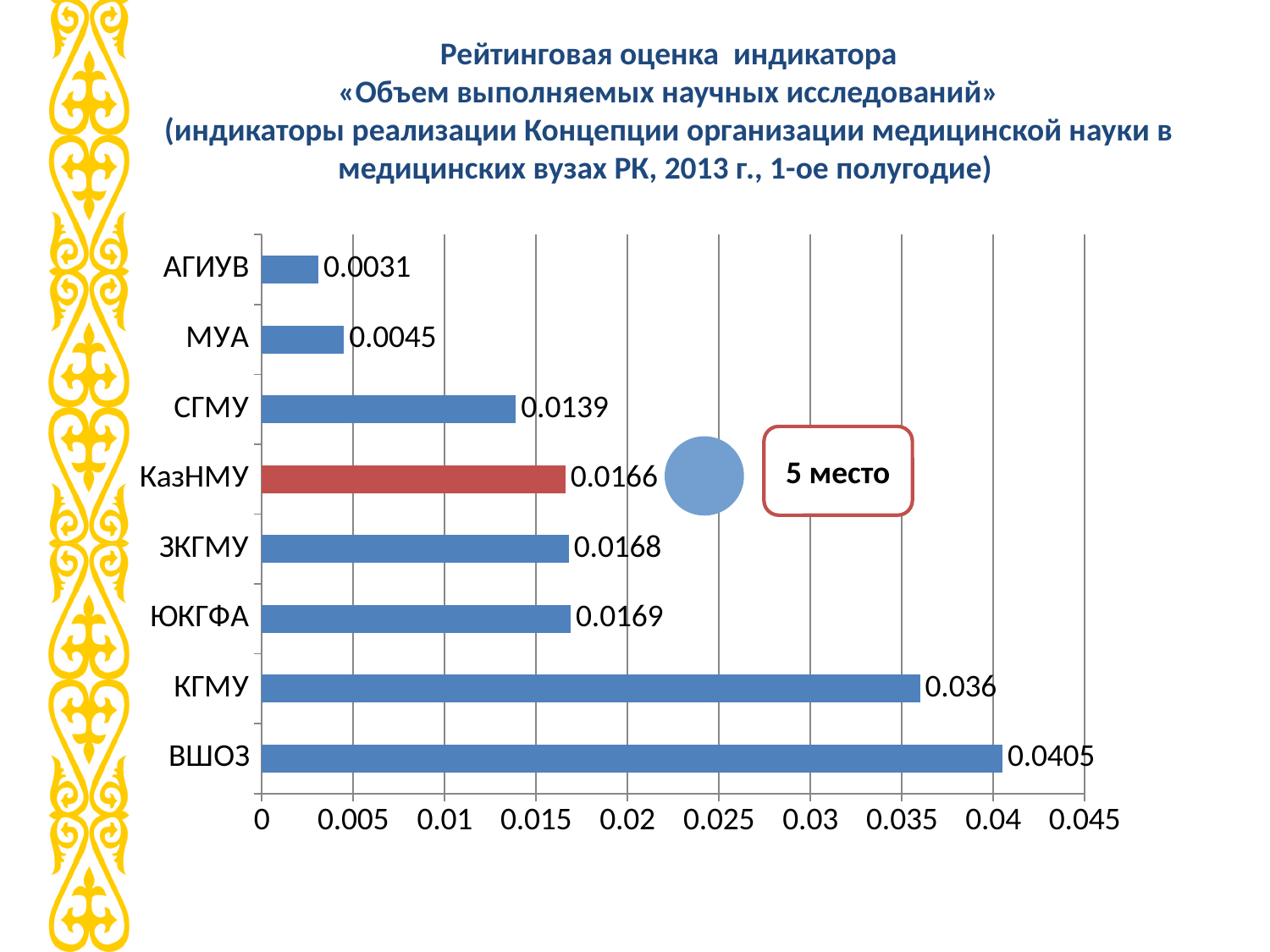
What is the value for ВШОЗ? 0.0405 Which is larger, the value for СГМУ or the value for МУА? СГМУ What kind of chart is shown on the slide? bar chart What is the value for АГИУВ? 0.0031 How many categories are shown in the chart? 8 What is the difference between the values for ВШОЗ and КГМУ? 0.0045 Which category has the lowest value? АГИУВ What rank is shown in the callout next to the КазНМУ bar? 5 место Which category has the highest value? ВШОЗ Is the value for КГМУ greater or less than 0.03? greater What is the value for КазНМУ? 0.0166 Which bar is coloured red instead of blue? КазНМУ